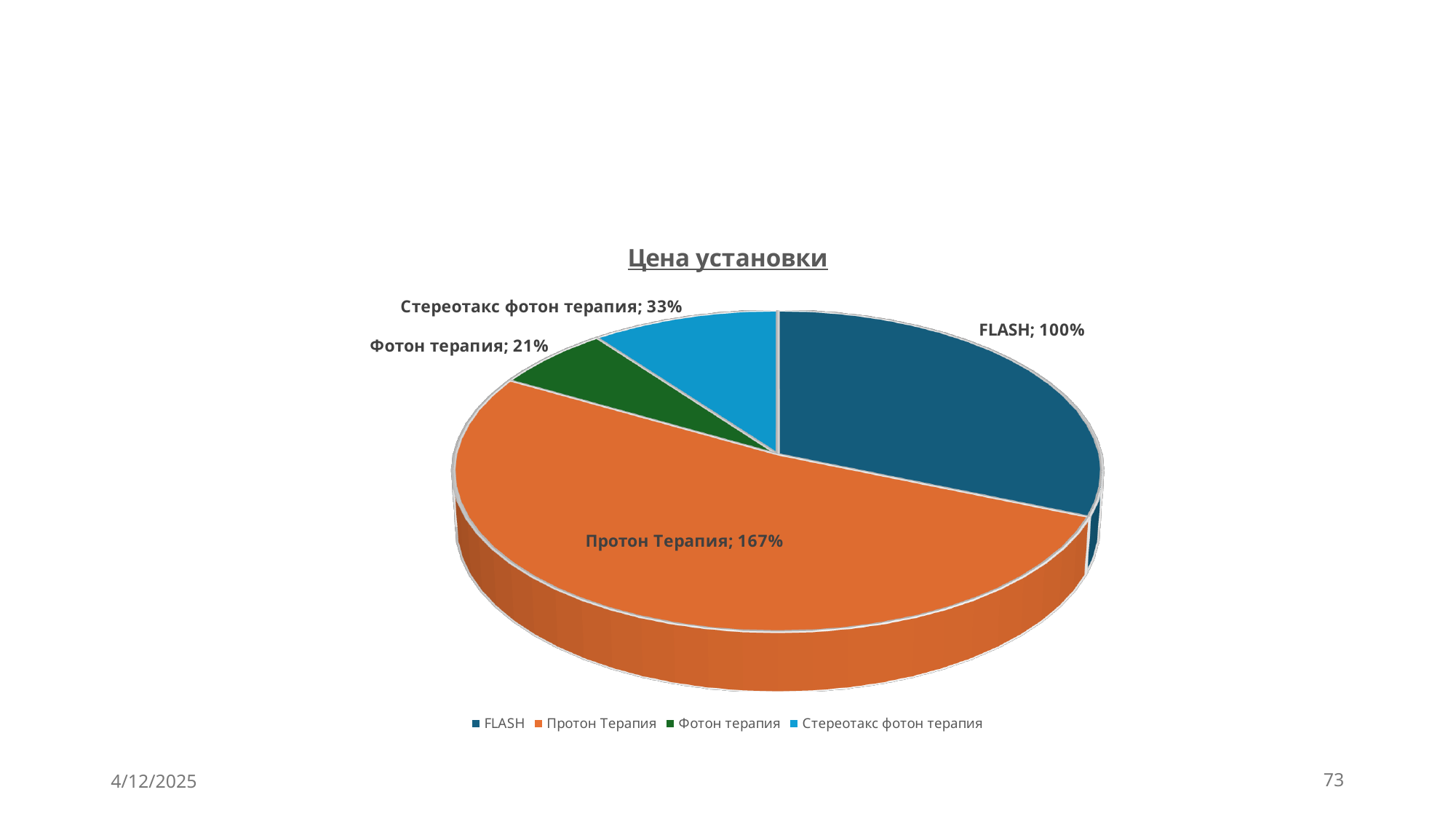
How many categories (slices) does the pie chart have? 4 What type of chart is shown on the slide? pie chart What is the value shown for Протон Терапия? 167% Which category has the largest slice of the pie? Протон Терапия What is the title of the chart? Цена установки Which category has the smallest slice of the pie? Фотон терапия How many entries are listed in the legend? 4 What is the value shown for FLASH? 100% What is the value shown for Стереотакс фотон терапия? 33% What is the value shown for Фотон терапия? 21% Which is larger, the value for Стереотакс фотон терапия or the value for Фотон терапия? Стереотакс фотон терапия By how many percentage points does Протон Терапия exceed FLASH? 67